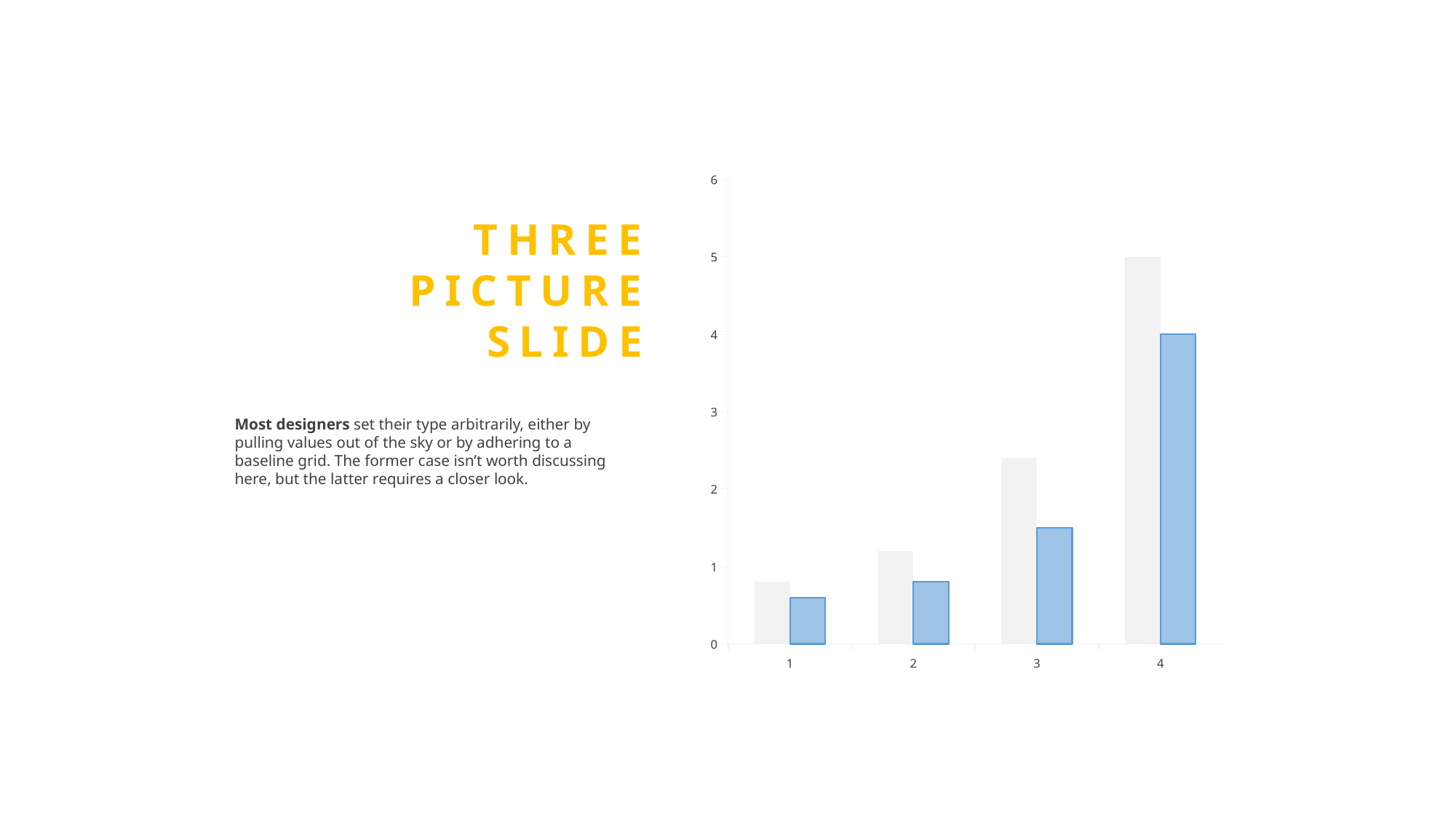
Is the value of the blue bar for category 1 greater or less than 1? less What is the difference between the grey bar and the blue bar for category 4? 1 Do the blue bars rise or fall from category 1 to category 4? rise Is the value of the grey bar for category 3 greater or less than 2? greater How many categories are shown on the x axis of the chart? 4 Which is larger for category 2, the grey bar or the blue bar? the grey bar Is the value of the blue bar for category 3 greater or less than 2? less Which category has the highest blue bar? 4 What is the value of the grey bar for category 4? 5 What kind of chart is shown on the slide? bar chart Which category has the lowest grey bar? 1 What is the value of the blue bar for category 4? 4